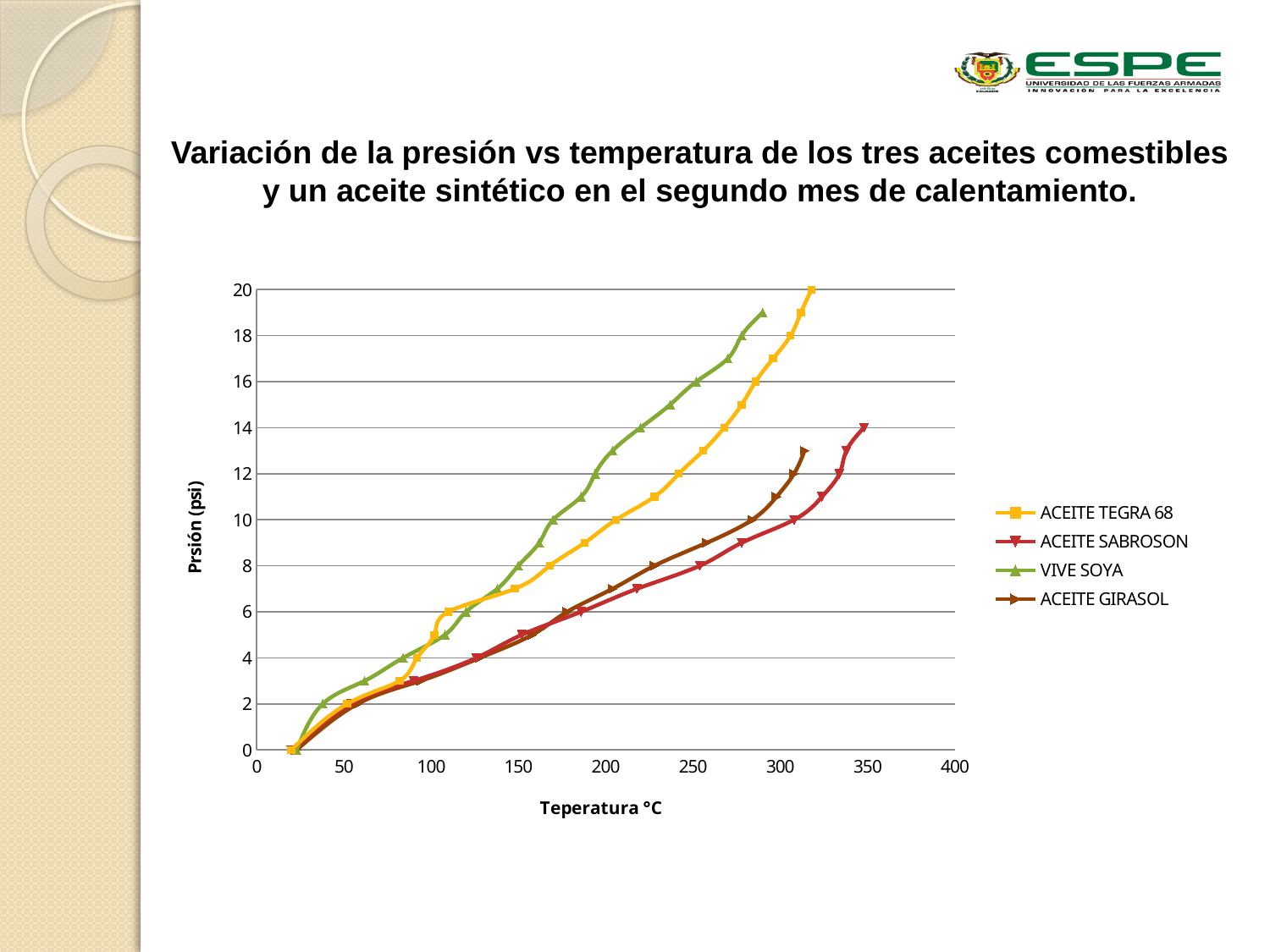
Does pressure rise or fall as temperature increases for all four series? Rise At 250 °C, which series shows the higher pressure, VIVE SOYA or ACEITE TEGRA 68? VIVE SOYA What is the label of the x axis? Teperatura °C At 200 °C, is the pressure for VIVE SOYA greater or less than 10 psi? greater What is the highest pressure value reached by the ACEITE TEGRA 68 series? 20 What kind of chart is shown on the slide? Line chart Which series extends to the highest temperature on the x axis? ACEITE SABROSON Which series reaches the highest pressure on the chart? ACEITE TEGRA 68 Which colour is used for the VIVE SOYA series? Green How many series does the legend list? 4 At 200 °C, is the pressure for ACEITE SABROSON greater or less than 8 psi? less What is the highest pressure value reached by the ACEITE SABROSON series? 14